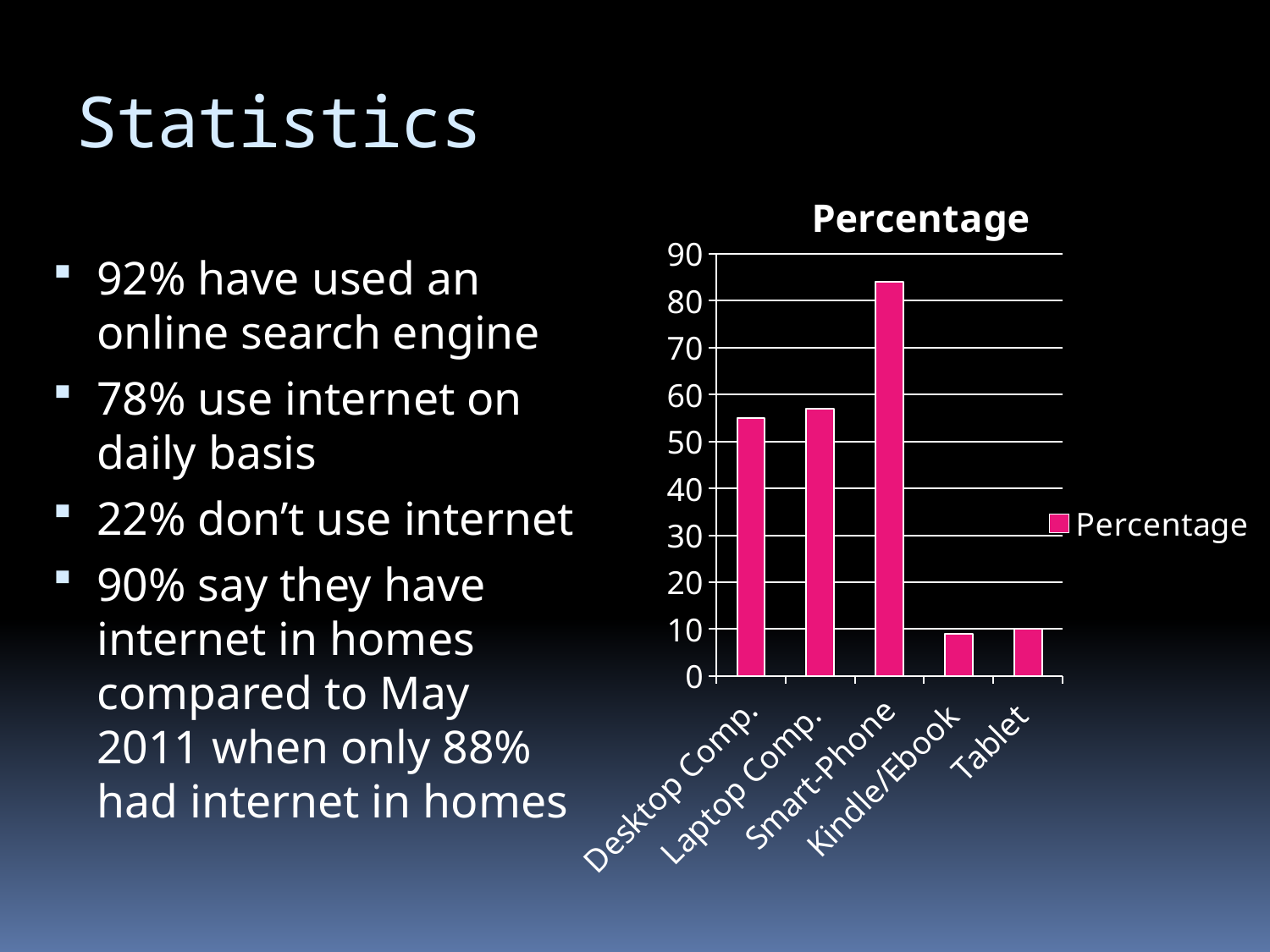
Which is larger, the value for Laptop Comp. or the value for Tablet? Laptop Comp. What is the title of the chart? Percentage Is the value for Kindle/Ebook greater or less than 20? less Is the value for Laptop Comp. greater or less than 60? less What is the name of the series listed in the chart's legend? Percentage Is the value for Desktop Comp. greater or less than 50? greater How many series does the chart's legend list? 1 How many categories are shown on the x axis of the chart? 5 Which category has the highest value in the chart? Smart-Phone Which is larger, the value for Smart-Phone or the value for Desktop Comp.? Smart-Phone What kind of chart is shown on the slide? bar chart